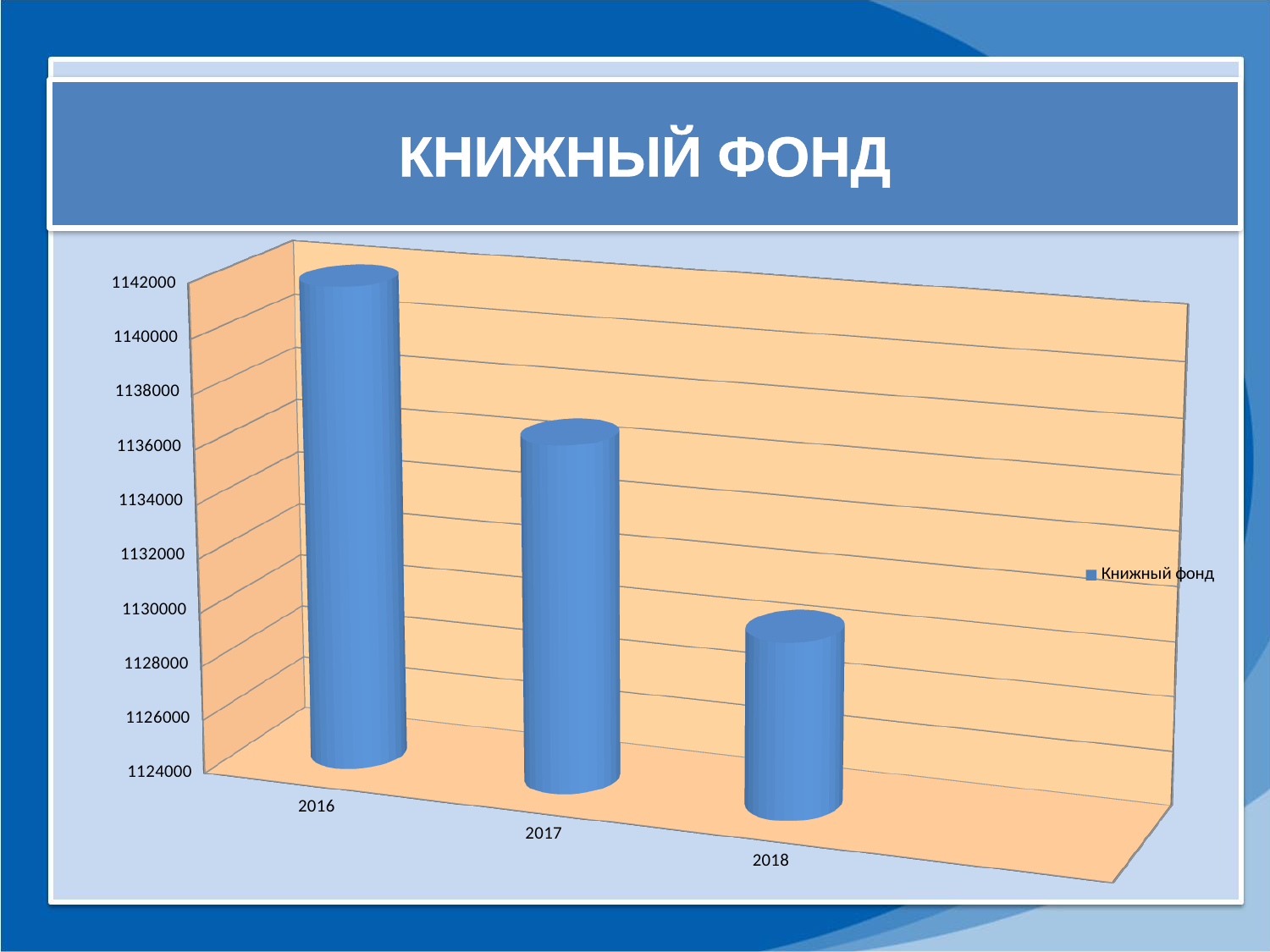
What is the title of the slide? КНИЖНЫЙ ФОНД What kind of chart is shown on the slide? bar chart Do the values rise or fall from 2016 to 2018? fall How many series does the legend list? 1 Which is larger, the value for 2017 or the value for 2018? 2017 Which year has the highest value in the chart? 2016 Which year has the lowest value in the chart? 2018 Is the value for 2017 greater or less than 1140000? less Is the value for 2016 greater or less than 1138000? greater Is the value for 2018 greater or less than 1134000? less How many years are shown on the x axis of the chart? 3 What is the name of the series shown in the legend? Книжный фонд